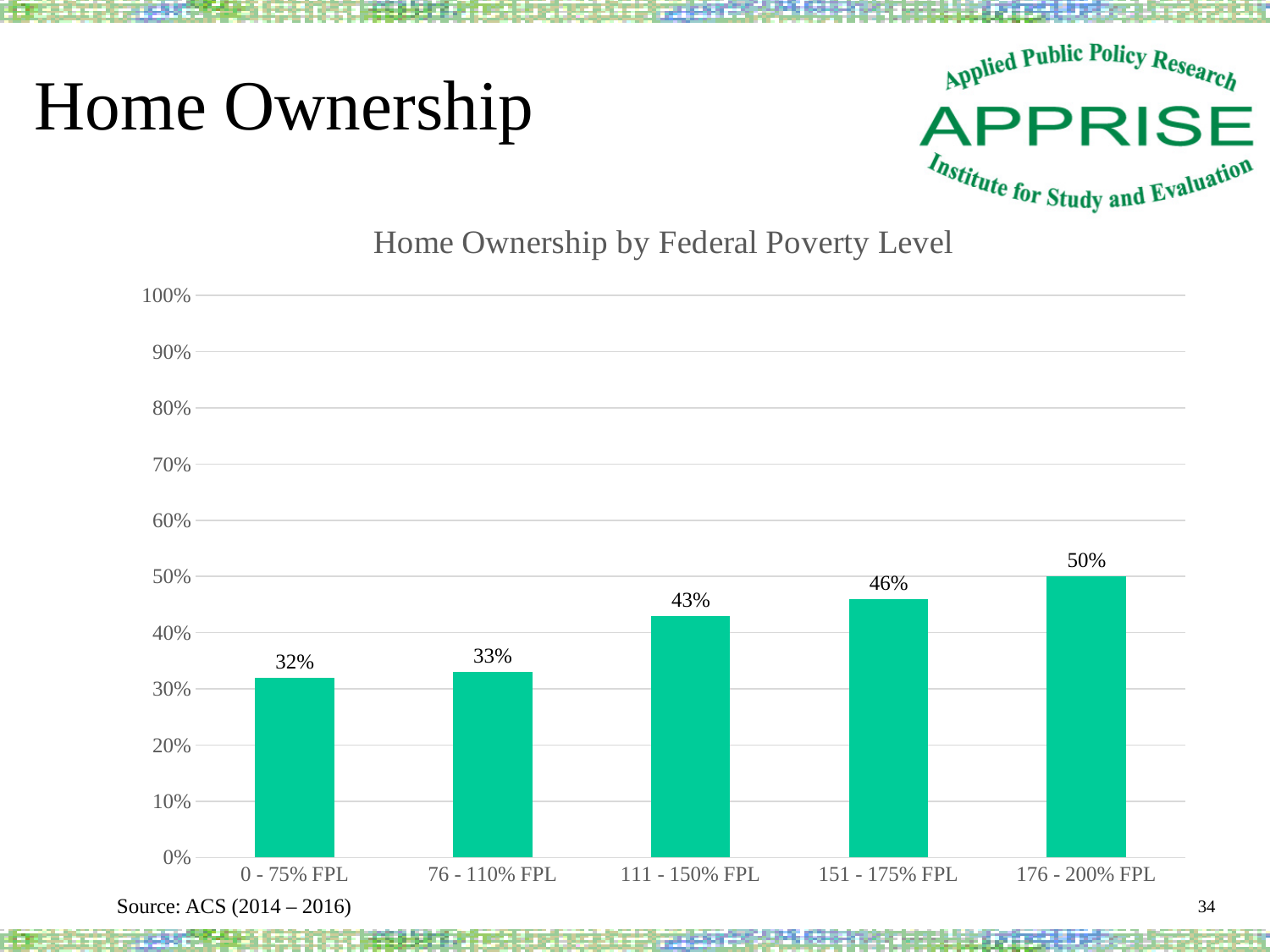
What is the difference in home ownership rate between the 151 - 175% FPL group and the 111 - 150% FPL group? 3% Is the home ownership rate for the 111 - 150% FPL group greater or less than 40%? greater How many federal poverty level groups are shown in the chart? 5 What is the home ownership rate for the 111 - 150% FPL group? 43% Does the home ownership rate rise or fall as the federal poverty level increases from left to right? Rises What is the home ownership rate for the 176 - 200% FPL group? 50% Which group has a higher home ownership rate, 76 - 110% FPL or 151 - 175% FPL? 151 - 175% FPL What is the home ownership rate for the 0 - 75% FPL group? 32% Which federal poverty level group has the lowest home ownership rate? 0 - 75% FPL What is the difference in home ownership rate between the 176 - 200% FPL group and the 0 - 75% FPL group? 18% Which federal poverty level group has the highest home ownership rate? 176 - 200% FPL What type of chart is used to show home ownership by federal poverty level? Bar chart